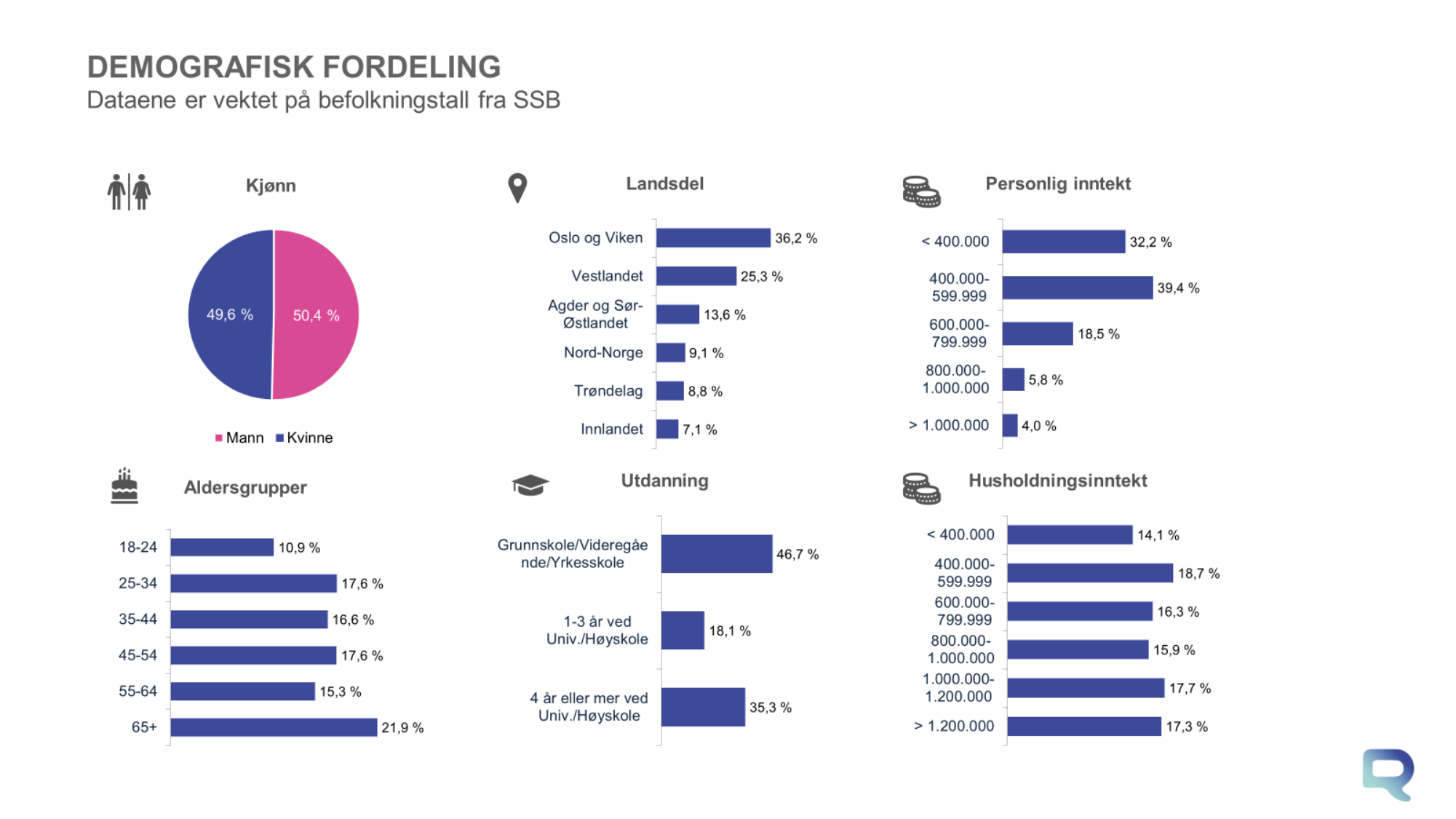
In the Landsdel chart, which region has the lowest value? Innlandet In the Aldersgrupper chart, how many age groups are shown? 6 In the Landsdel chart, what is the value for Vestlandet? 25,3 % What kind of chart is the Kjønn chart? pie chart In the Kjønn chart, what share is shown for Mann? 50,4 % In the Husholdningsinntekt chart, which income group has the lowest value? < 400.000 In the Aldersgrupper chart, which age group has the highest value? 65+ In the Husholdningsinntekt chart, what is the value for 1.000.000-1.200.000? 17,7 % In the Personlig inntekt chart, what is the value for > 1.000.000? 4,0 % In the Utdanning chart, which is larger: 1-3 år ved Univ./Høyskole or 4 år eller mer ved Univ./Høyskole? 4 år eller mer ved Univ./Høyskole In the Landsdel chart, what is the difference between Oslo og Viken and Nord-Norge? 27,1 % In the Personlig inntekt chart, which income group has the highest value? 400.000-599.999